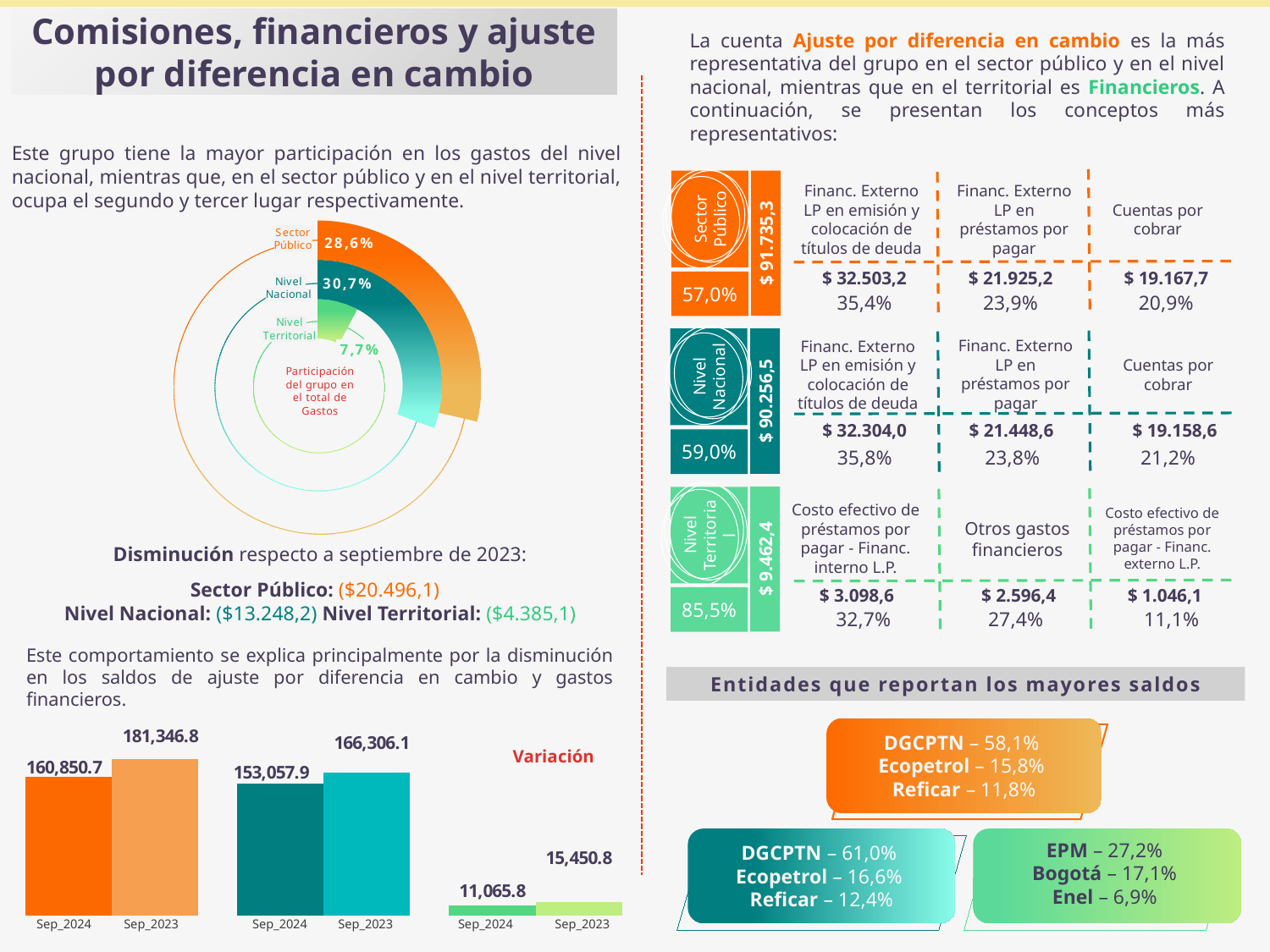
In the bar chart at the bottom left, what is the value of the green bar labelled Sep_2024? 11,065.8 What type of chart is shown at the bottom left of the slide? Bar chart In the radial chart 'Participación del grupo en el total de Gastos', which category has the highest value? Nivel Nacional In the radial chart 'Participación del grupo en el total de Gastos', how many categories are shown? 3 In the bar chart at the bottom left, which is larger for the teal pair: Sep_2024 or Sep_2023? Sep_2023 In the bar chart at the bottom left, what is the difference between the orange Sep_2023 bar and the orange Sep_2024 bar? 20,496.1 In the bar chart at the bottom left, what is the value of the first orange bar labelled Sep_2024? 160,850.7 In the radial chart 'Participación del grupo en el total de Gastos', what is the value for Nivel Nacional? 30,7% In the radial chart 'Participación del grupo en el total de Gastos', what is the value for Sector Público? 28,6% In the radial chart 'Participación del grupo en el total de Gastos', which category has the lowest value? Nivel Territorial In the bar chart at the bottom left, what is the difference between the green Sep_2023 bar and the green Sep_2024 bar? 4,385.0 In the bar chart at the bottom left, what is the value of the teal bar labelled Sep_2023? 166,306.1